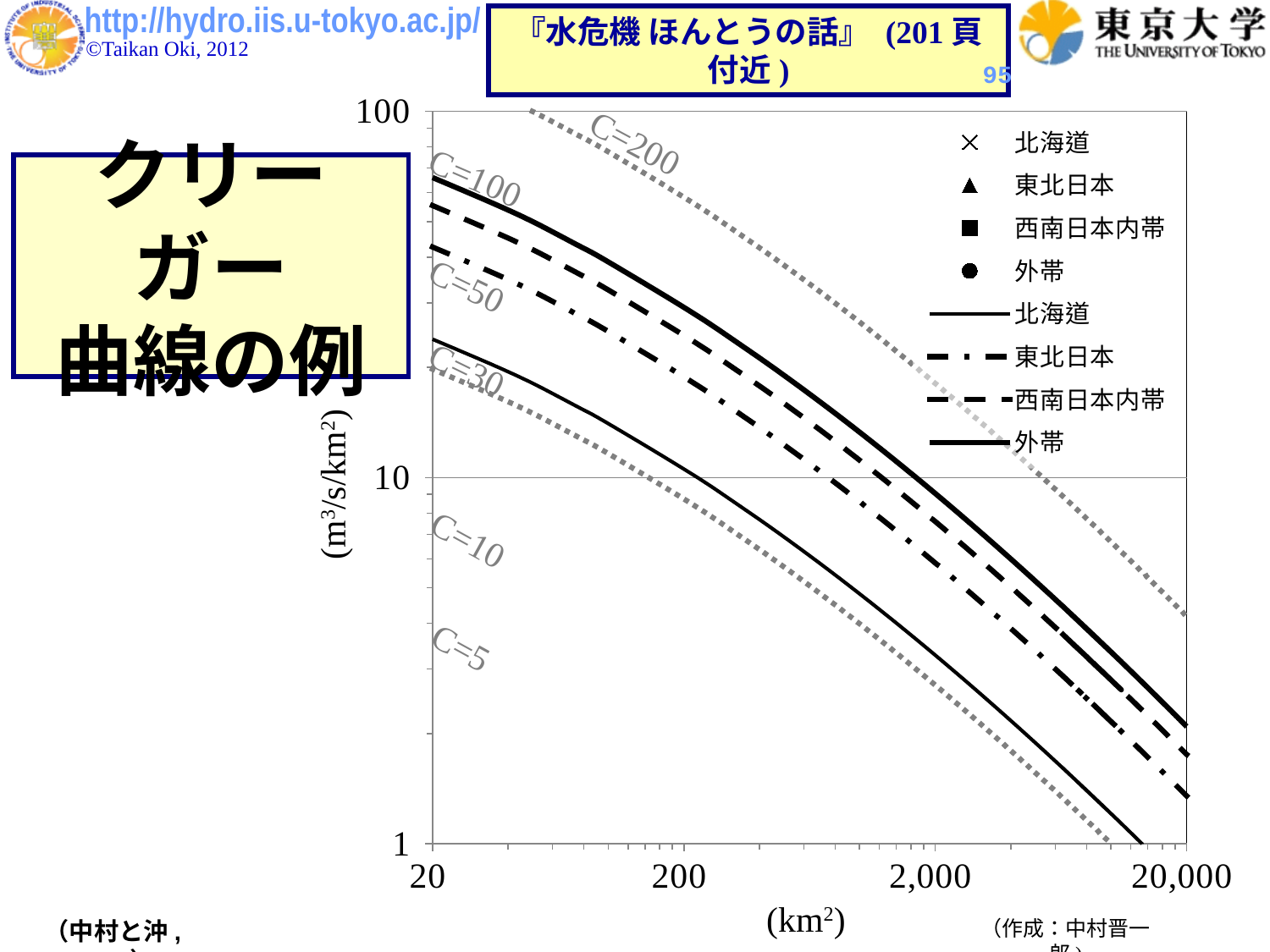
Which region's curve lies highest on the chart? 外帯 At 20 km², is the value of the 東北日本 curve greater or less than 10? greater What unit is shown on the y axis of the chart? m³/s/km² What is the largest value labelled on the x axis of the chart? 20,000 Do the plotted curves rise or fall as the catchment area on the x axis increases? fall At 2,000 km², is the value of the 北海道 curve greater or less than 10? less Which region's curve lies lowest on the chart? 北海道 At 200 km², is the value of the 外帯 curve greater or less than 10? greater How many entries does the chart legend list? 8 What kind of chart is shown on the slide? line chart At 2,000 km², which curve has the larger value, 外帯 or 北海道? 外帯 How many dotted gray C-value curves (C=5, C=10, ...) are labelled on the chart? 6